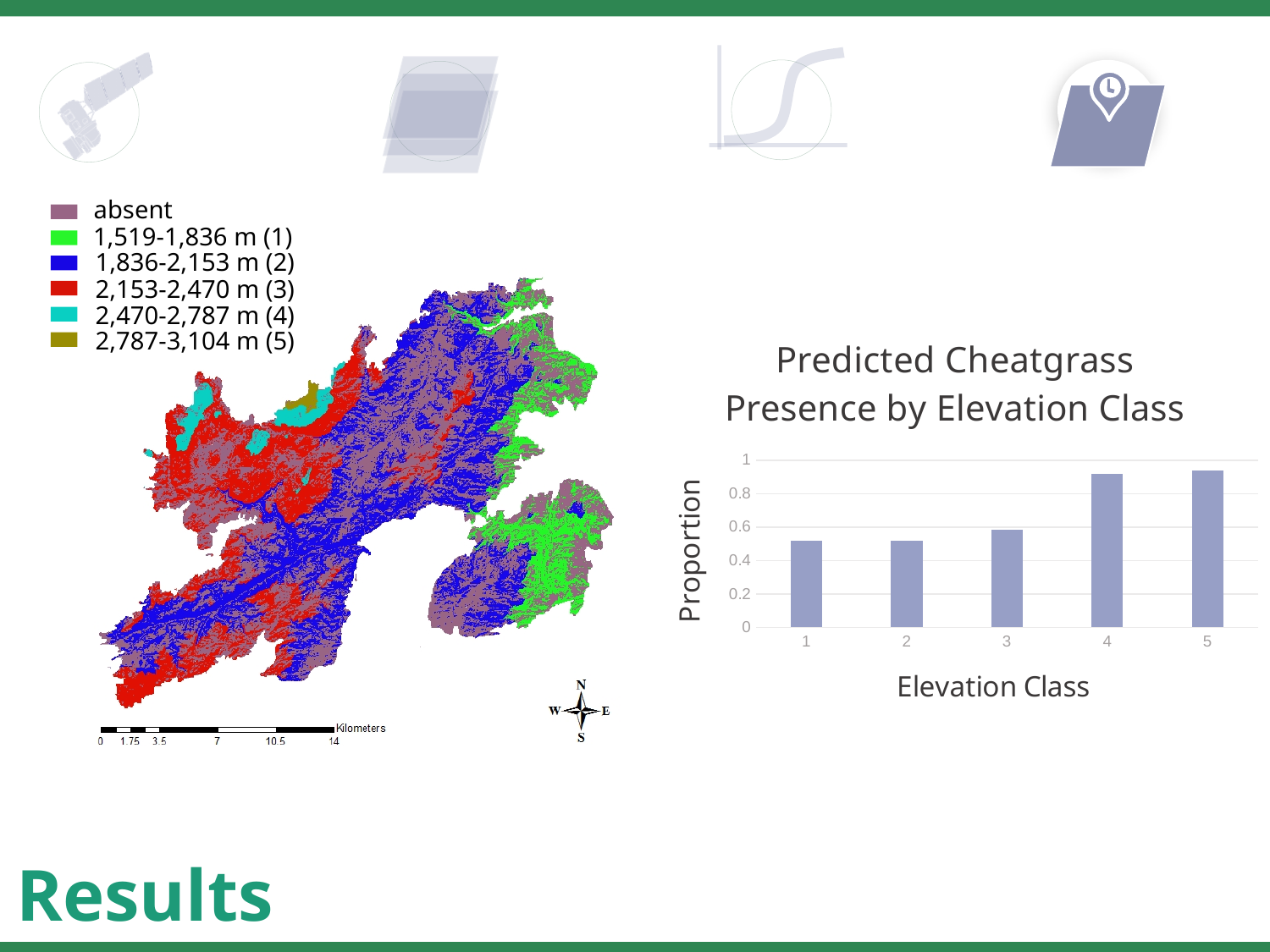
In the 'Predicted Cheatgrass Presence by Elevation Class' chart, is the proportion for elevation class 5 greater or less than 0.8? greater In the 'Predicted Cheatgrass Presence by Elevation Class' chart, is the proportion for elevation class 2 greater or less than 0.6? less In the 'Predicted Cheatgrass Presence by Elevation Class' chart, which has the larger proportion, elevation class 5 or elevation class 2? elevation class 5 In the 'Predicted Cheatgrass Presence by Elevation Class' chart, is the proportion for elevation class 3 greater or less than 0.4? greater In the 'Predicted Cheatgrass Presence by Elevation Class' chart, does the proportion generally rise or fall as the elevation class increases from 1 to 5? rise How many elevation classes are plotted in the 'Predicted Cheatgrass Presence by Elevation Class' chart? 5 What is the label on the horizontal axis of the 'Predicted Cheatgrass Presence by Elevation Class' chart? Elevation Class What kind of chart is 'Predicted Cheatgrass Presence by Elevation Class'? bar chart In the 'Predicted Cheatgrass Presence by Elevation Class' chart, which has the larger proportion, elevation class 1 or elevation class 4? elevation class 4 What is the label on the vertical axis of the 'Predicted Cheatgrass Presence by Elevation Class' chart? Proportion